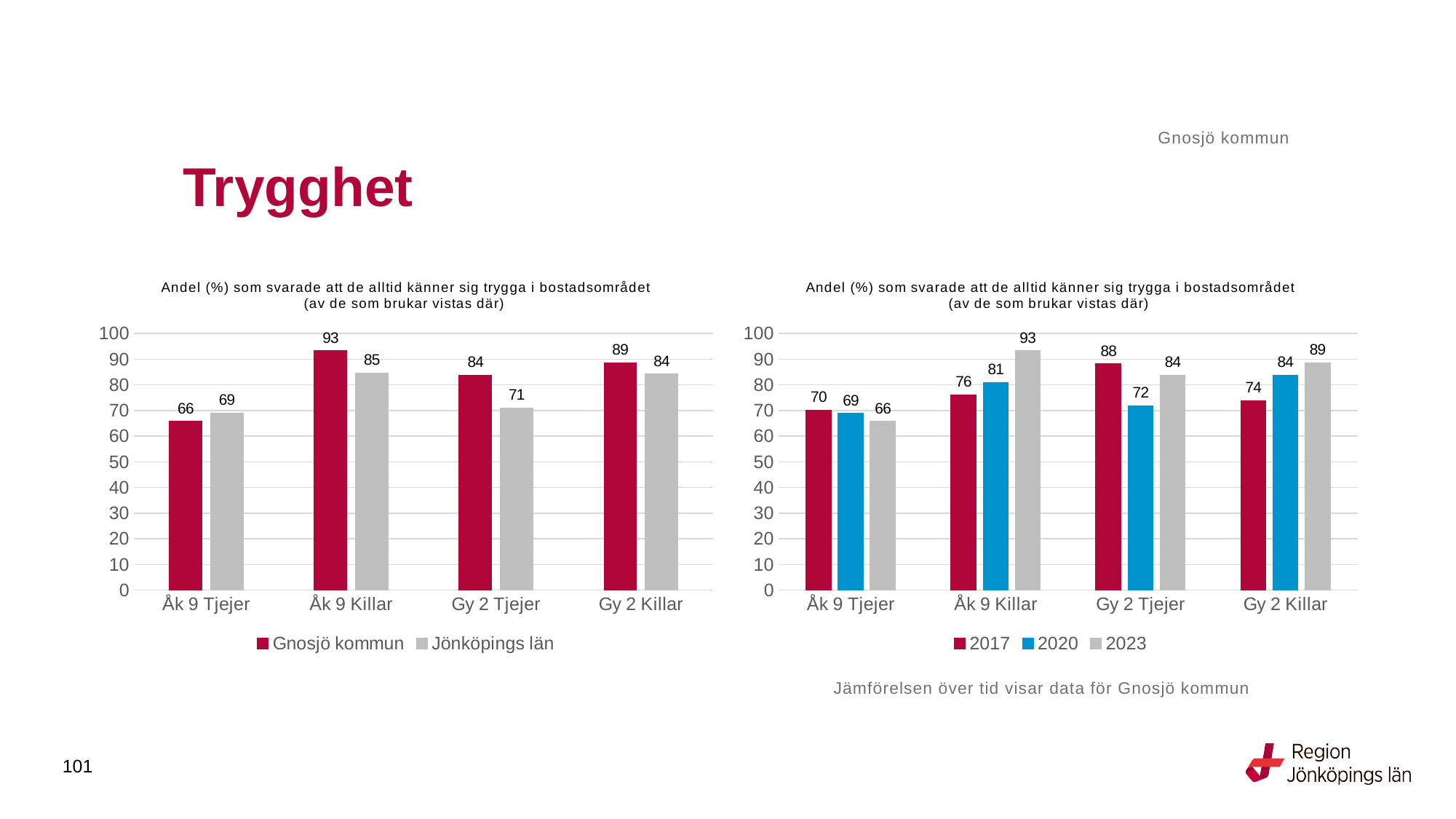
In the right chart, how many categories are shown on the x axis? 4 In the left chart, which is larger for Åk 9 Tjejer: Gnosjö kommun or Jönköpings län? Jönköpings län What kind of chart is the right chart? Bar chart How many series does the legend of the left chart list? 2 In the left chart, what is the value for Jönköpings län for Gy 2 Tjejer? 71 In the left chart, what is the value for Gnosjö kommun for Åk 9 Killar? 93 In the right chart, what is the value for 2020 for Gy 2 Tjejer? 72 In the right chart, what is the value for 2023 for Åk 9 Killar? 93 In the right chart, what is the difference between 2017 and 2023 for Åk 9 Killar? 17 In the left chart, what is the difference between Gnosjö kommun and Jönköpings län for Gy 2 Tjejer? 13 In the right chart, which category has the highest value for 2017? Gy 2 Tjejer In the left chart, which category has the lowest value for Gnosjö kommun? Åk 9 Tjejer